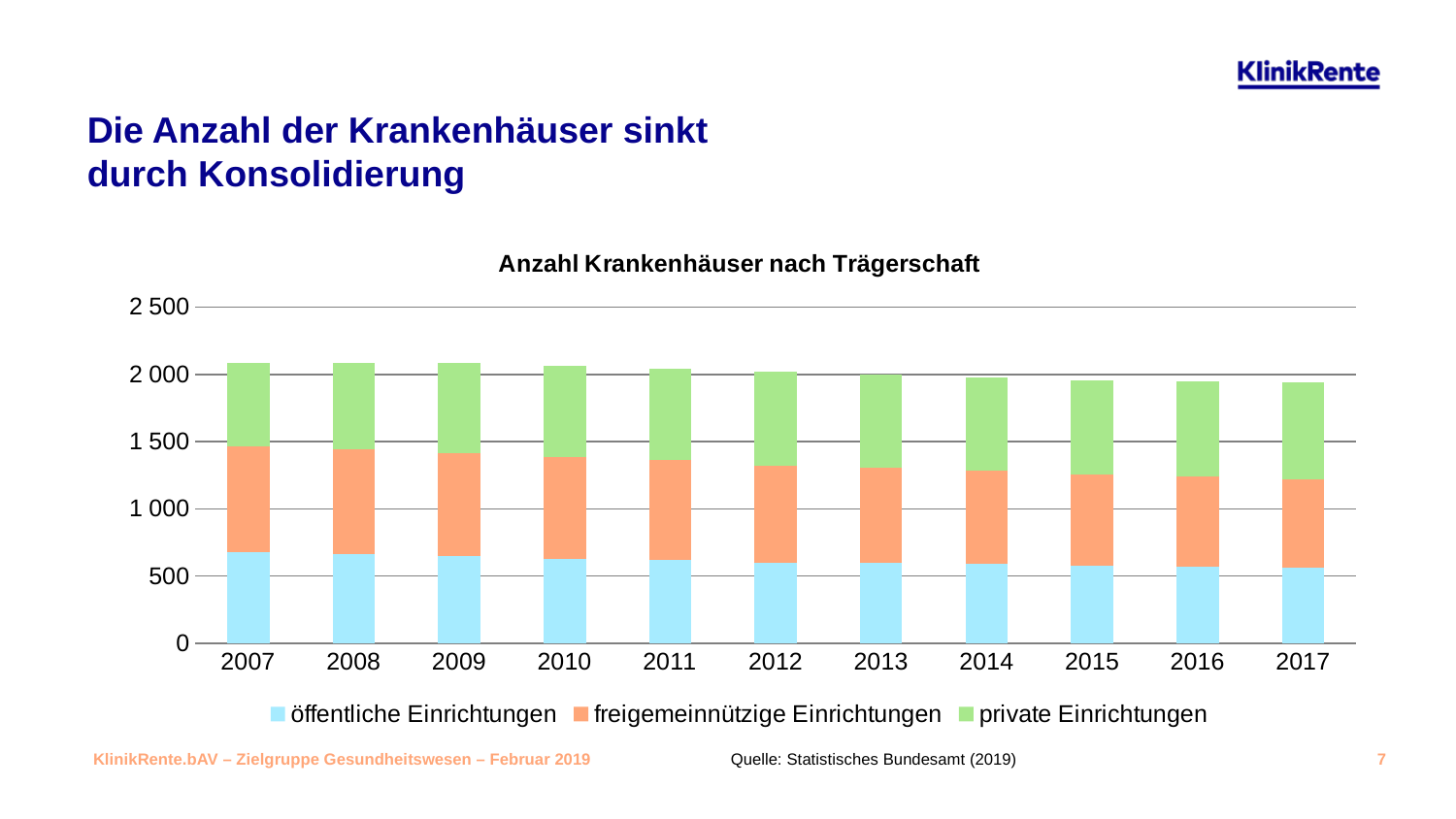
Which series is shown in light blue at the bottom of each bar? öffentliche Einrichtungen How many years are shown on the x axis of the chart? 11 What kind of chart is shown on the slide? Stacked bar chart Which year has the larger value for freigemeinnützige Einrichtungen, 2007 or 2017? 2007 Is the value for öffentliche Einrichtungen in 2007 greater or less than 1 000? less Which year has the larger total number of hospitals, 2007 or 2017? 2007 Is the value for öffentliche Einrichtungen in 2007 greater or less than 500? greater Is the total number of hospitals in 2007 greater or less than 2 000? greater Does the total number of hospitals rise or fall from 2007 to 2017? fall How many series does the chart's legend list? 3 What is the title of the chart? Anzahl Krankenhäuser nach Trägerschaft